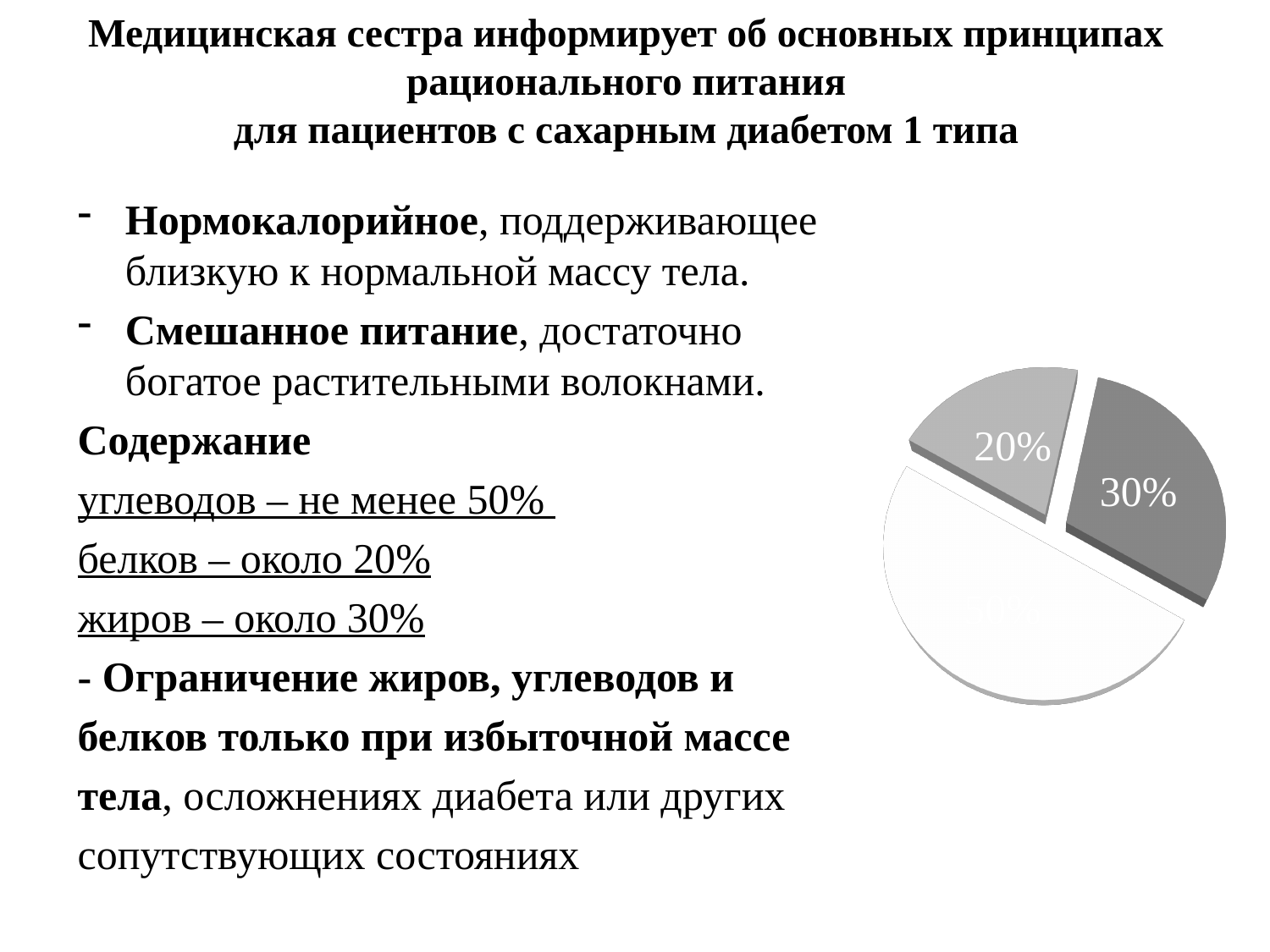
What is the difference between the two labelled slices of the pie chart (30% and 20%)? 10 percentage points How many slices does the pie chart have? 3 What value is printed on the light grey slice of the pie chart? 20% What colour is the largest slice of the pie chart? white Which slice of the pie chart is the largest? the white slice Which of the two labelled slices of the pie chart is larger, the dark grey one or the light grey one? the dark grey one (30%) Of the two labelled slices in the pie chart, which has the smaller value? the light grey slice (20%) What do the two labelled slices of the pie chart add up to? 50% How many slices of the pie chart carry a printed percentage label? 2 What value is printed on the dark grey slice of the pie chart? 30% What kind of chart is shown on the right side of the slide? pie chart